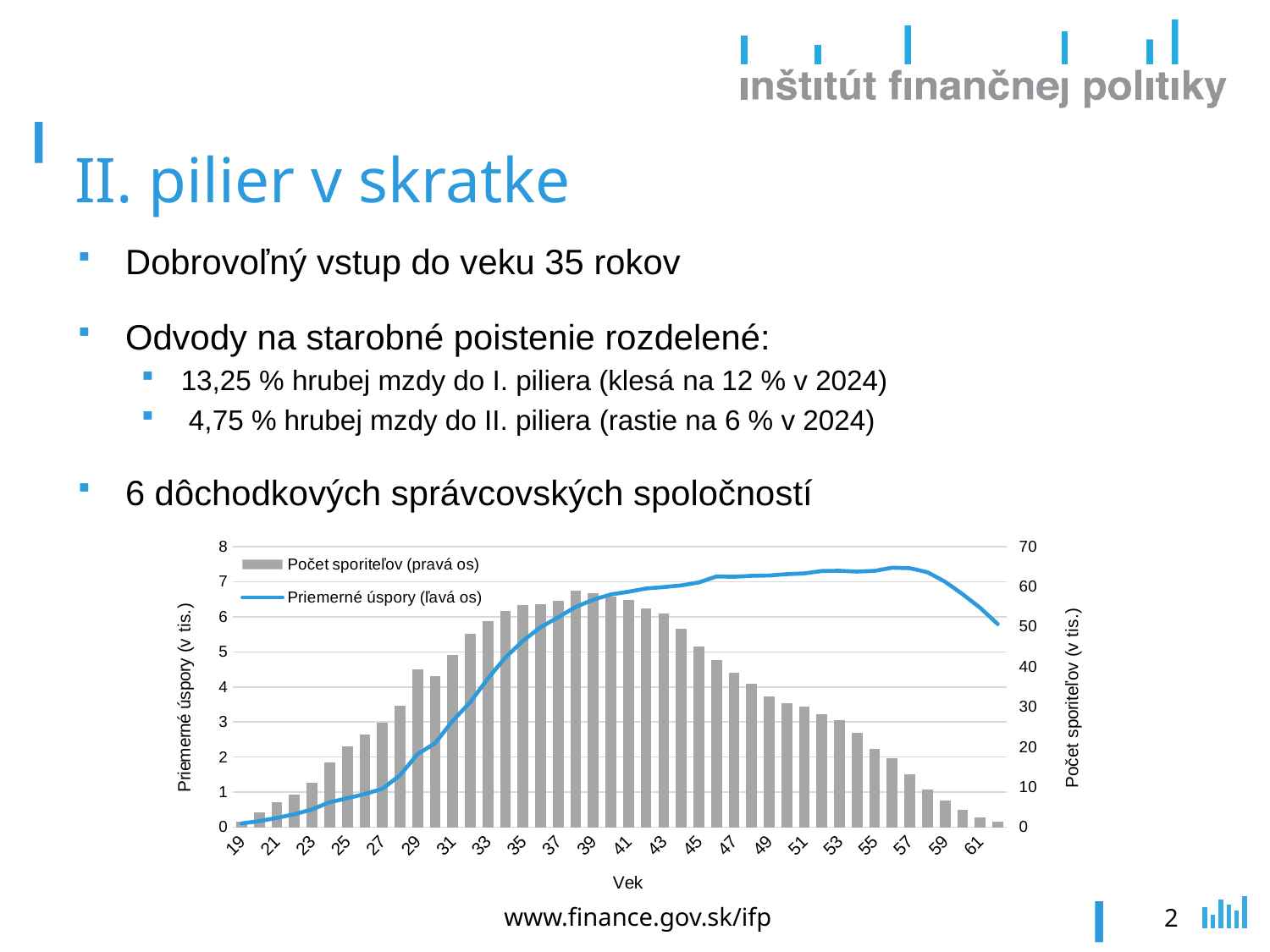
How many series does the chart legend list? 2 Is the value of Počet sporiteľov for age 50 greater or less than 40? less Is the value of Priemerné úspory for age 19 greater or less than 1? less Does the Priemerné úspory line rise or fall between age 19 and age 45? Rise What is the title of the x axis of the chart? Vek Which is larger, the Priemerné úspory value at age 30 or at age 40? Age 40 Which series is plotted as bars in the chart? Počet sporiteľov (pravá os) Is the value of Počet sporiteľov for age 38 greater or less than 50? greater What kind of chart is shown on the slide? Combined bar and line chart Which is larger, the Počet sporiteľov bar for age 29 or for age 53? Age 29